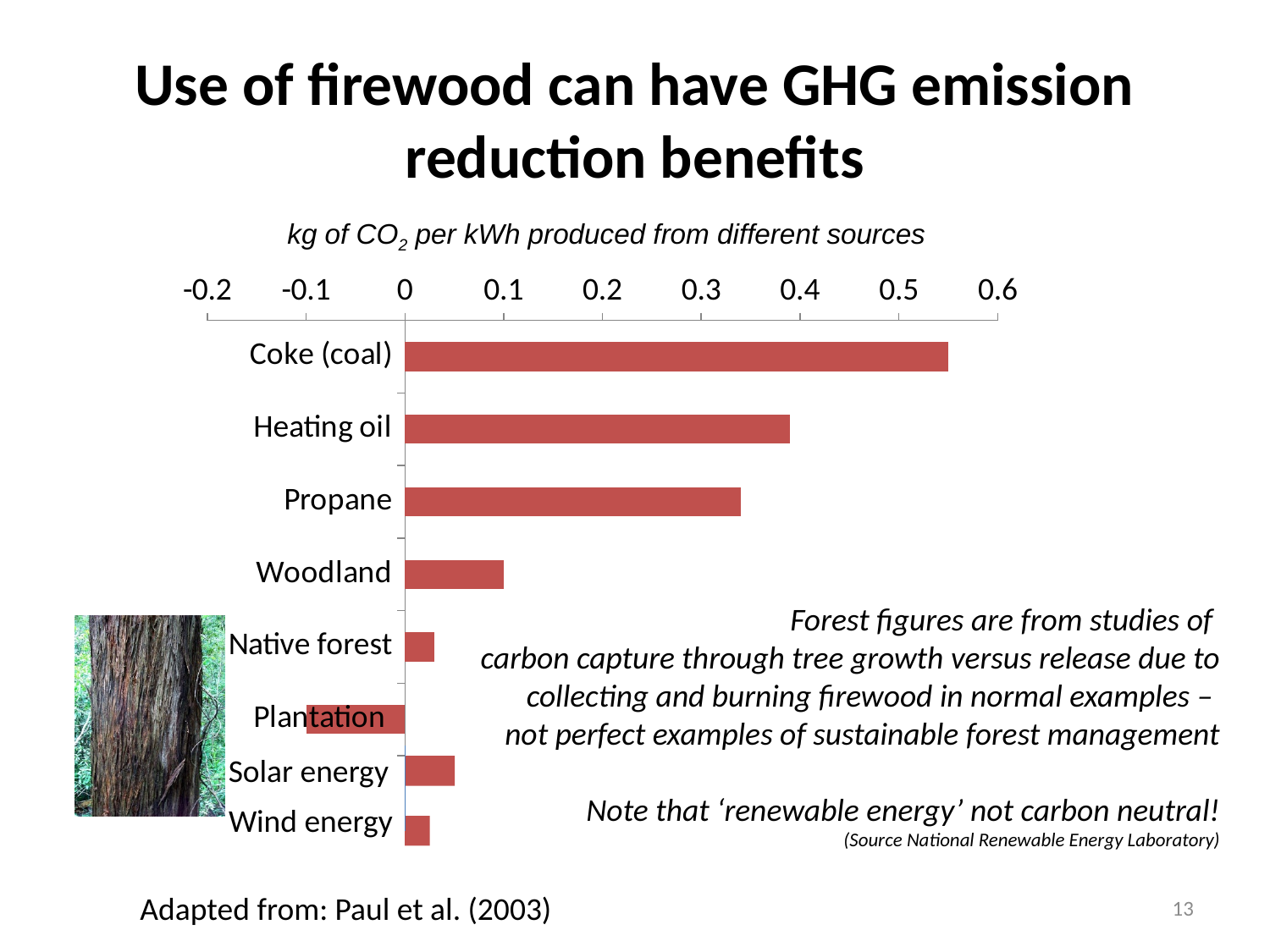
Is the value for Coke (coal) greater or less than 0.5? greater Which energy source has the lowest kg of CO2 per kWh in the chart? Plantation Is the value for Heating oil greater or less than 0.3? greater Which has a larger value, Coke (coal) or Heating oil? Coke (coal) Is the value for Propane greater or less than 0.4? less Which has a larger value, Woodland or Native forest? Woodland Which energy source has the highest kg of CO2 per kWh in the chart? Coke (coal) What kind of chart is shown on the slide? bar chart How many energy sources (categories) are plotted in the chart? 8 What is the title of the chart? kg of CO2 per kWh produced from different sources